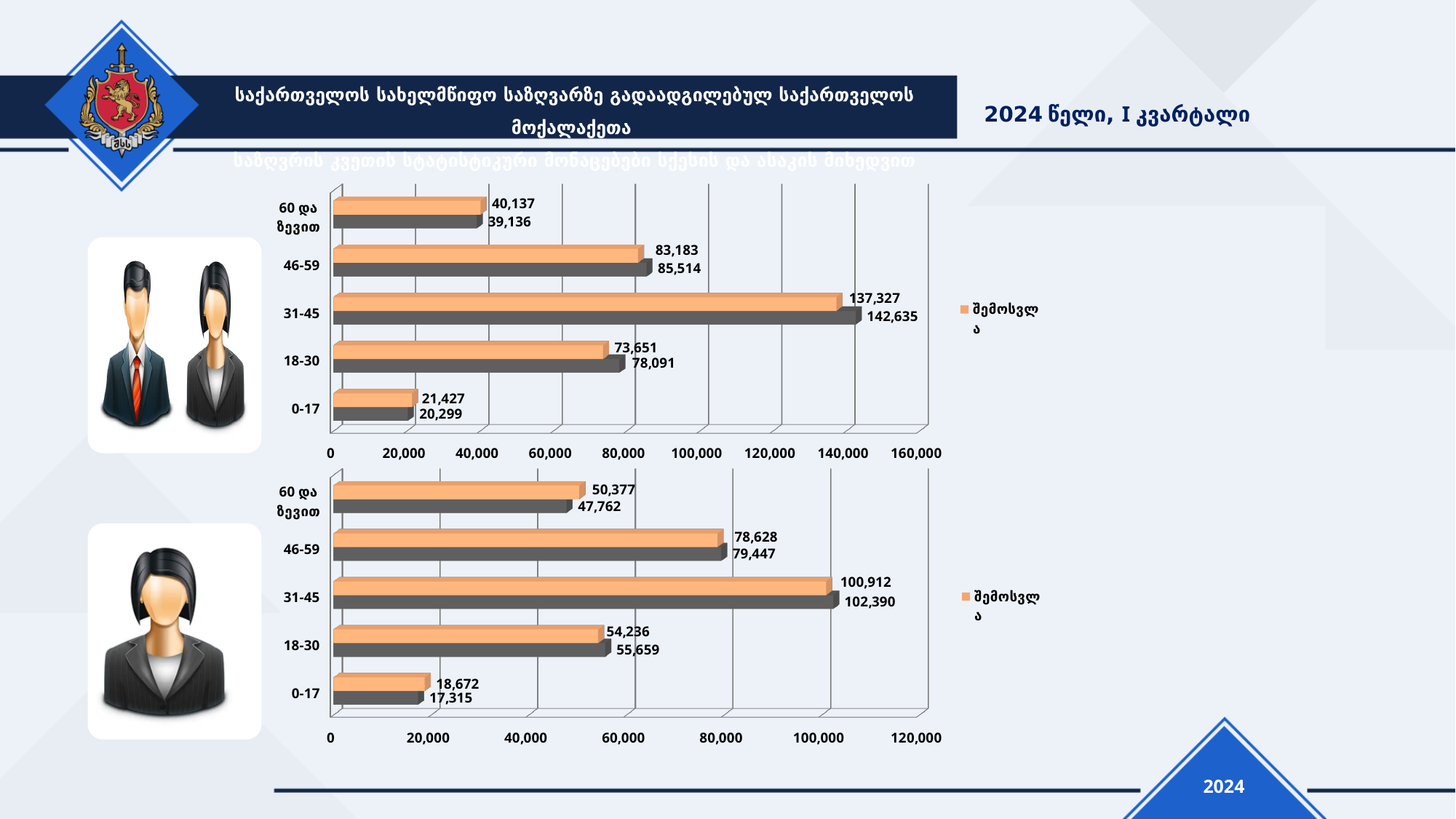
In the bottom chart, what is the difference between the orange values for 46-59 and 18-30? 24,392 In the top chart, what is the difference between the grey and orange values for the 31-45 age group? 5,308 In the top chart, which is larger for the 60 და ზევით group: the orange value or the grey value? the orange value (40,137) In the bottom chart, which age group has the lowest grey bar value? 0-17 In the top chart, what is the orange (შემოსვლა) value for the 31-45 age group? 137,327 In the bottom chart, what is the orange (შემოსვლა) value for the 0-17 age group? 18,672 In the top chart, what is the grey bar value for the 46-59 age group? 85,514 How many age groups are shown on the bottom chart? 5 What type of chart is the top chart? bar chart In the bottom chart, what is the grey bar value for the 18-30 age group? 55,659 In the top chart, which age group has the highest orange (შემოსვლა) value? 31-45 In the bottom chart, is the orange value for 31-45 greater or less than 100,000? greater